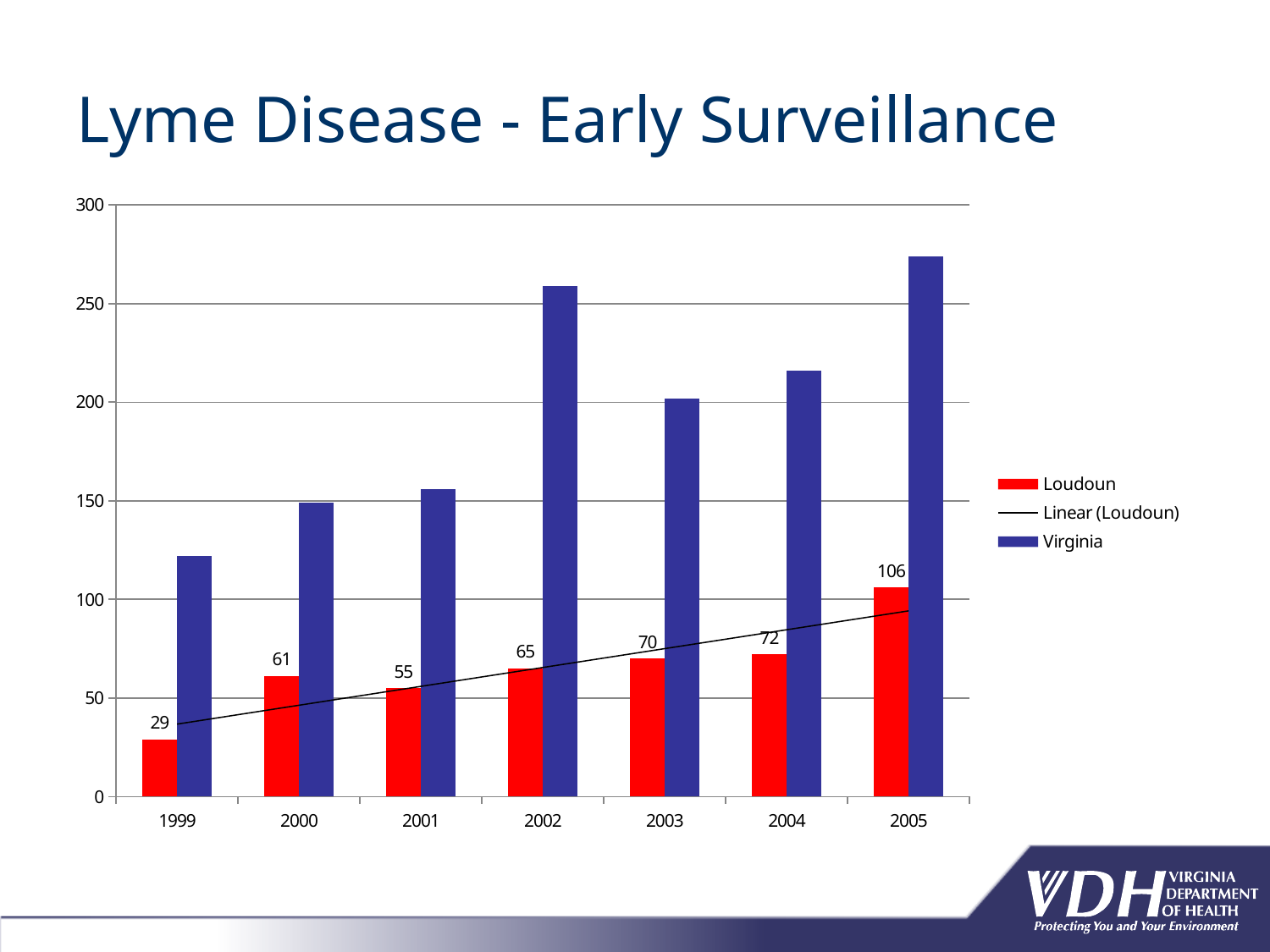
What is the Loudoun value for 2005? 106 What is the Loudoun value for 1999? 29 How many entries does the legend list? 3 What kind of chart is shown on the slide? Bar chart What is the difference between the Loudoun values for 2005 and 2004? 34 Which year has the highest Loudoun value? 2005 How many years are shown on the x axis? 7 Which is larger, the Loudoun value for 2000 or for 2001? 2000 Which year has the lowest Loudoun value? 1999 What is the Loudoun value for 2001? 55 Is the Virginia value for 1999 greater or less than 150? less Is the Virginia value for 2002 greater or less than 250? greater